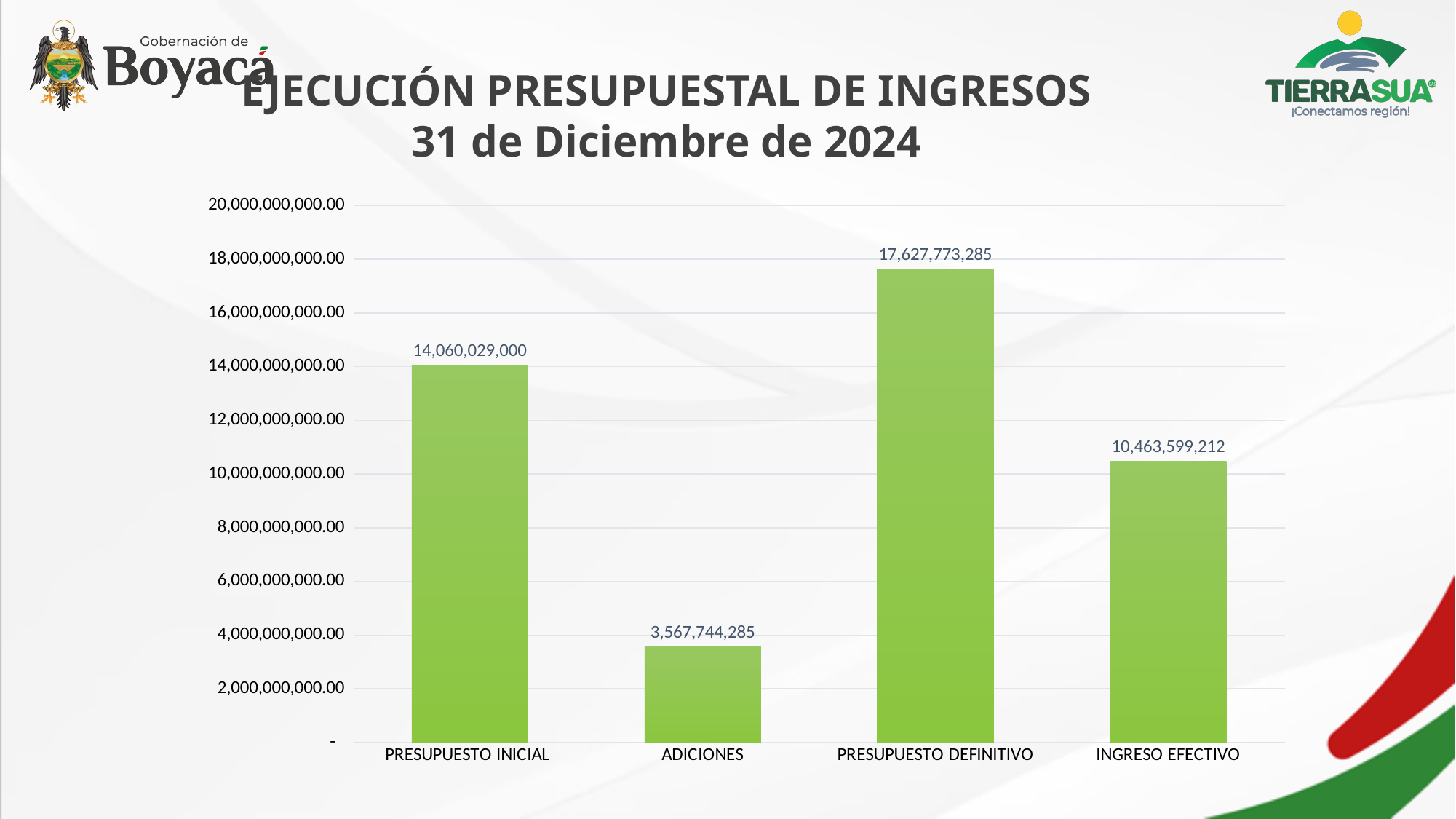
How many categories are shown on the x axis? 4 What is the difference between PRESUPUESTO DEFINITIVO and PRESUPUESTO INICIAL? 3,567,744,285 Which is larger, PRESUPUESTO INICIAL or INGRESO EFECTIVO? PRESUPUESTO INICIAL What is the difference between PRESUPUESTO DEFINITIVO and INGRESO EFECTIVO? 7,164,174,073 Which category has the lowest value? ADICIONES What is the value for PRESUPUESTO INICIAL? 14,060,029,000 What is the value for PRESUPUESTO DEFINITIVO? 17,627,773,285 What kind of chart is shown on the slide? bar chart Which category has the highest value? PRESUPUESTO DEFINITIVO Is the value for INGRESO EFECTIVO greater or less than 12,000,000,000.00? less What is the value for ADICIONES? 3,567,744,285 What is the value for INGRESO EFECTIVO? 10,463,599,212